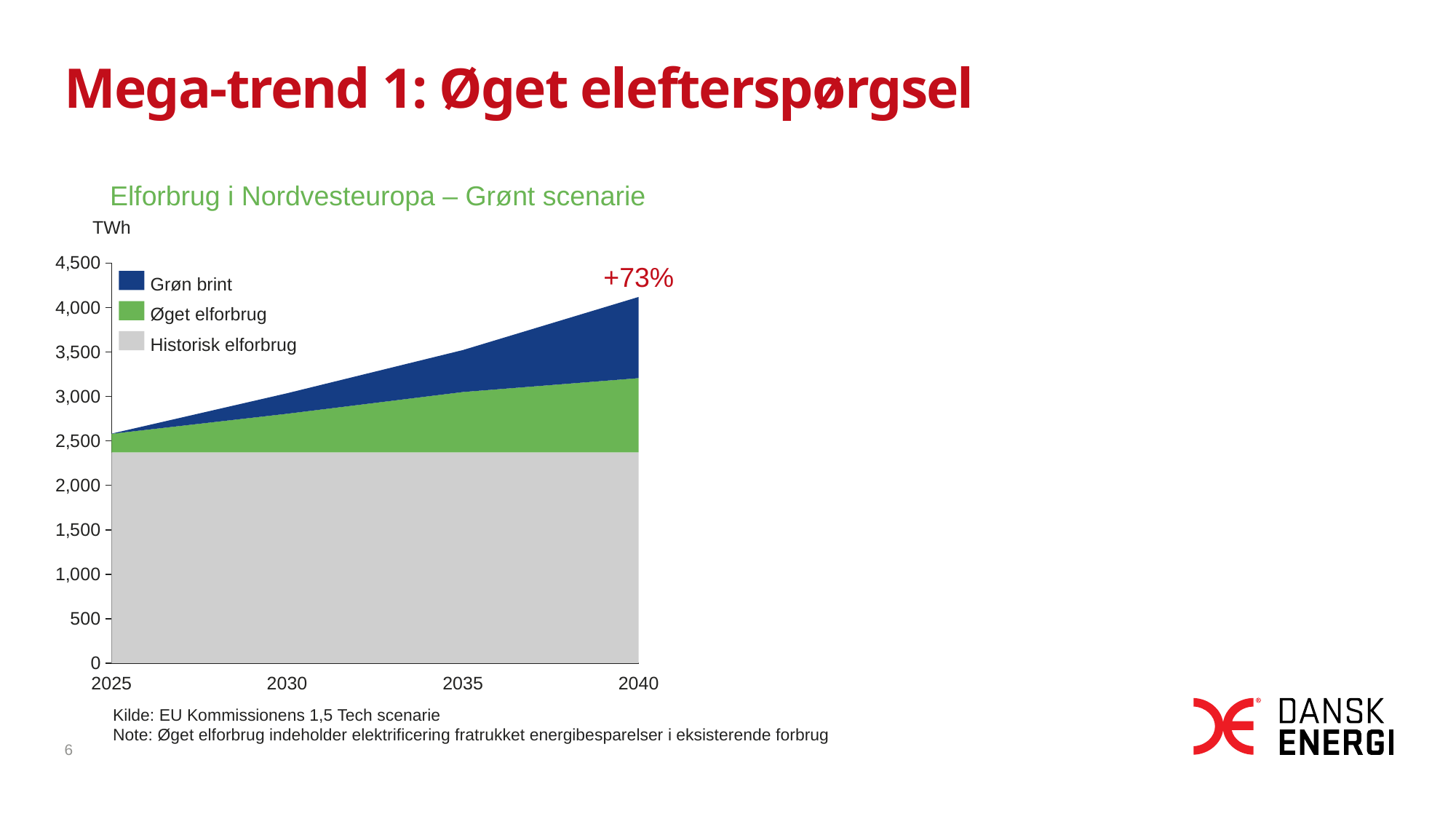
What is the title of the chart? Elforbrug i Nordvesteuropa – Grønt scenarie What percentage change is annotated at the top of the chart for 2040? +73% Which series is shown in dark blue? Grøn brint Is the total value in 2040 greater or less than 4,000? greater How many series does the legend list? 3 What kind of chart is shown on the slide? Stacked area chart Is the value for Historisk elforbrug greater or less than 2,500? less What unit is shown on the y axis? TWh What are the three series listed in the legend? Grøn brint, Øget elforbrug, Historisk elforbrug Is the total value in 2025 greater or less than 3,000? less Does total electricity consumption rise or fall from 2025 to 2040? Rise How many year labels are shown on the x axis? 4